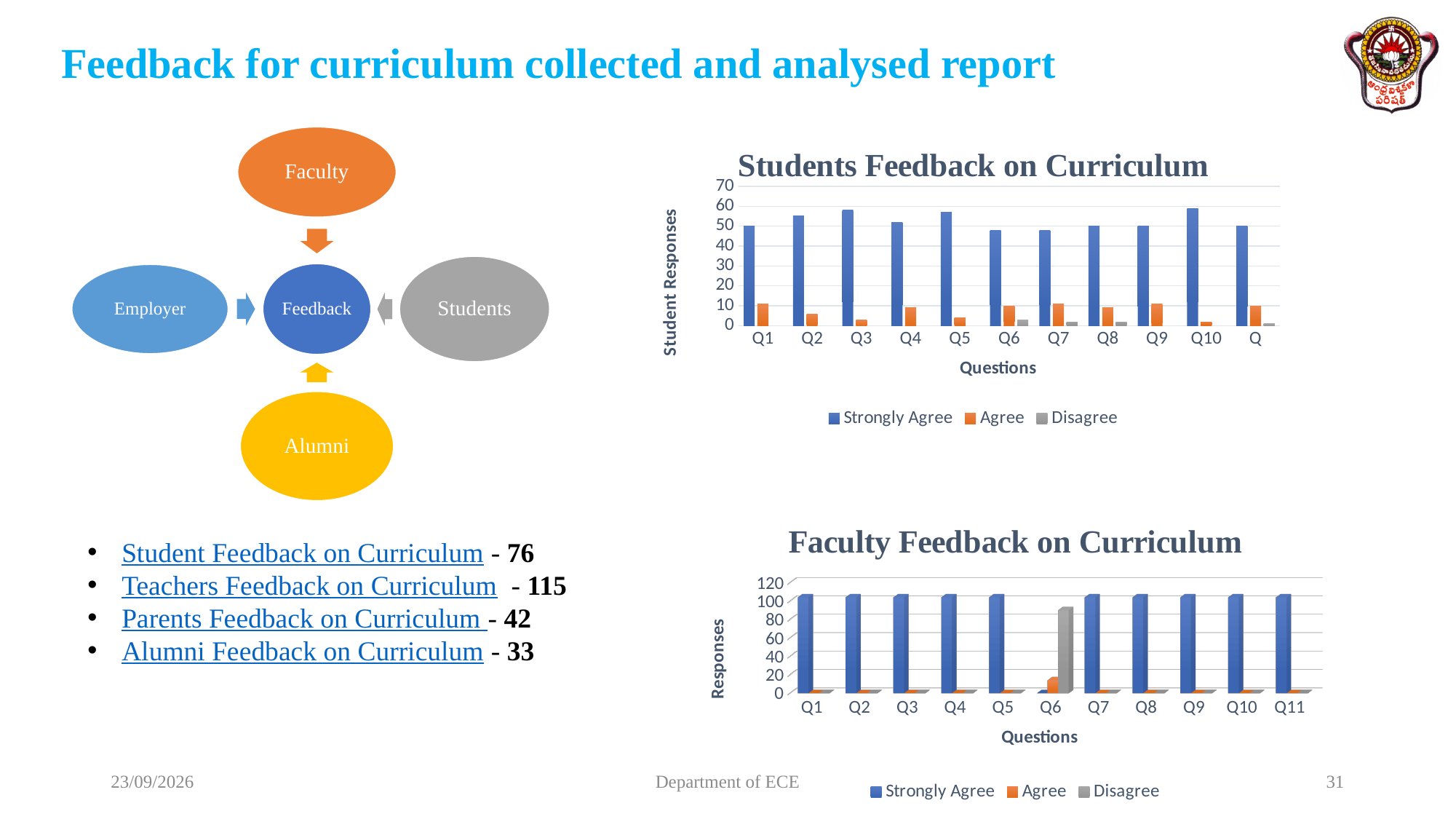
How many questions are shown on the x axis of the "Faculty Feedback on Curriculum" chart? 11 In the "Students Feedback on Curriculum" chart, is the Agree value for Q3 greater or less than 10? less In the "Faculty Feedback on Curriculum" chart, which question has the highest Disagree value? Q6 In the "Students Feedback on Curriculum" chart, which is larger: the Strongly Agree value for Q2 or for Q6? Q2 In the "Faculty Feedback on Curriculum" chart, which is larger for Q6: the Agree value or the Disagree value? Disagree In the "Faculty Feedback on Curriculum" chart, is the Disagree value for Q6 greater or less than 80? greater What is the y-axis title of the "Students Feedback on Curriculum" chart? Student Responses In the "Faculty Feedback on Curriculum" chart, which question has the lowest Strongly Agree value? Q6 In the "Students Feedback on Curriculum" chart, is the Strongly Agree value for Q2 greater or less than 50? greater How many series does the legend of the "Students Feedback on Curriculum" chart list? 3 What kind of chart is the "Students Feedback on Curriculum" chart? Bar chart